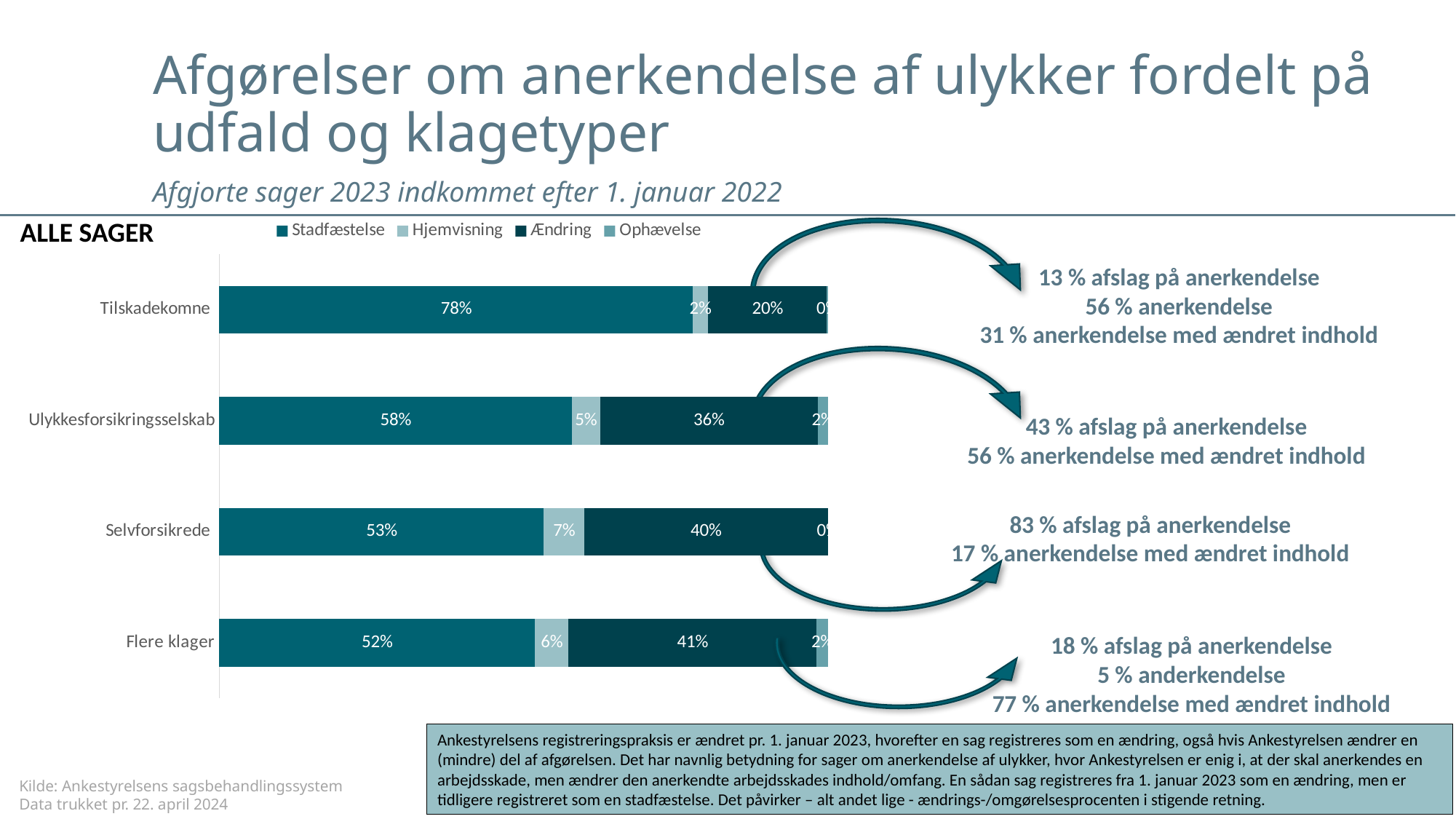
What is the Ændring share for Ulykkesforsikringsselskab? 36% Which category has the highest Stadfæstelse share? Tilskadekomne Which category has the lowest Ændring share? Tilskadekomne Which series is listed first in the chart legend? Stadfæstelse What kind of chart is shown on the slide? Stacked bar chart Which is larger: the Ændring share for Selvforsikrede or for Ulykkesforsikringsselskab? Selvforsikrede What is the Ophævelse share for Flere klager? 2% What is the Stadfæstelse share for Tilskadekomne? 78% What is the Hjemvisning share for Selvforsikrede? 7% How many categories are shown on the chart? 4 How many series does the legend list? 4 What is the difference between the Stadfæstelse share for Tilskadekomne and for Flere klager? 26%